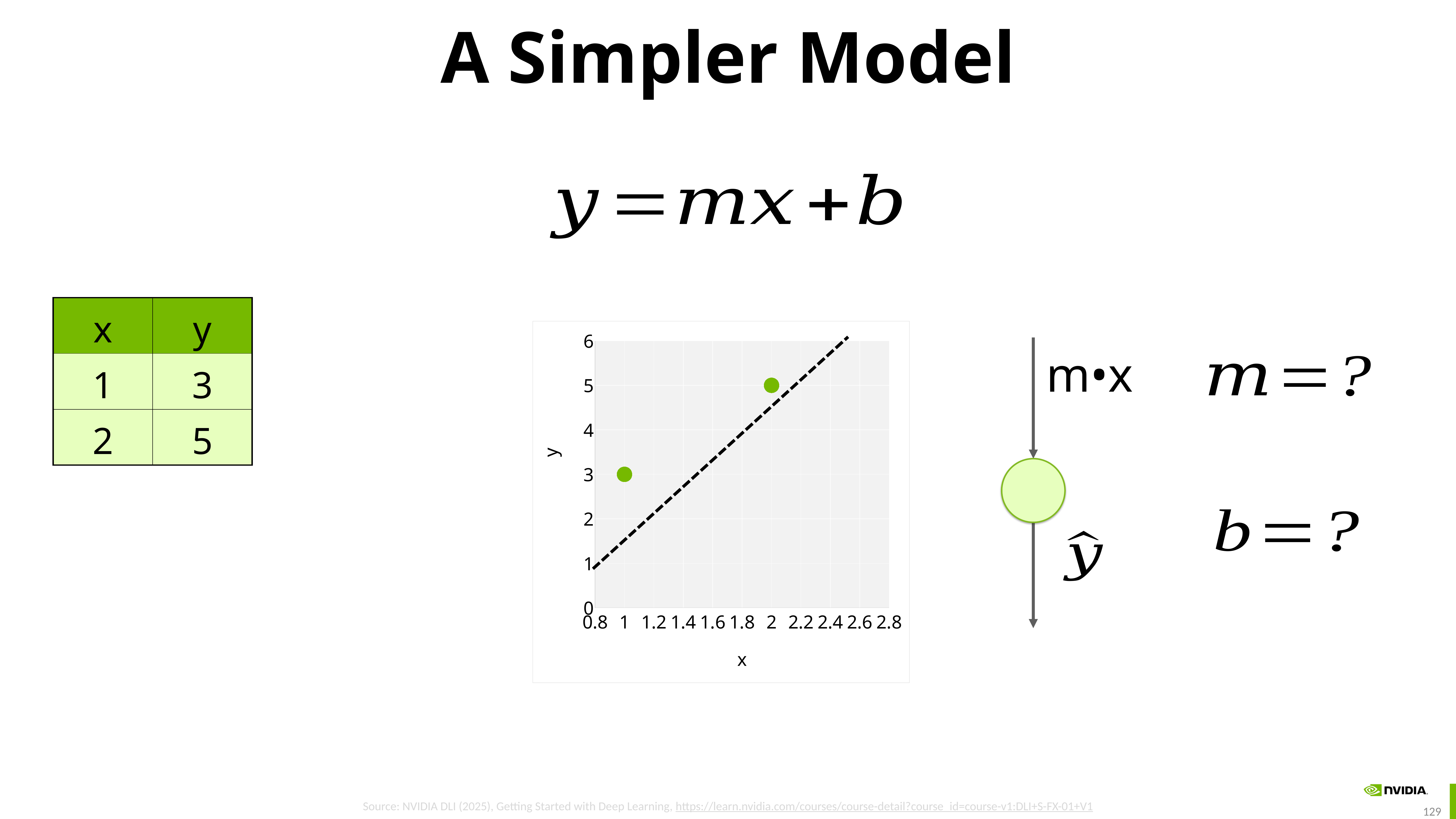
Is the y value of the point at x = 2 greater or less than 4? greater At which x value does the plotted point with the highest y value occur? 2 What is the highest value shown on the chart's y axis? 6 At which x value does the plotted point with the lowest y value occur? 1 What is the y value of the plotted point at x = 1? 3 Do the plotted y values rise or fall as x increases? rise What is the label on the vertical axis of the chart? y How many data points are plotted on the chart? 2 Which point has the higher y value, the one at x = 1 or the one at x = 2? x = 2 What is the difference in y between the point at x = 2 and the point at x = 1? 2 What kind of chart is shown on the slide? scatter chart What is the y value of the plotted point at x = 2? 5